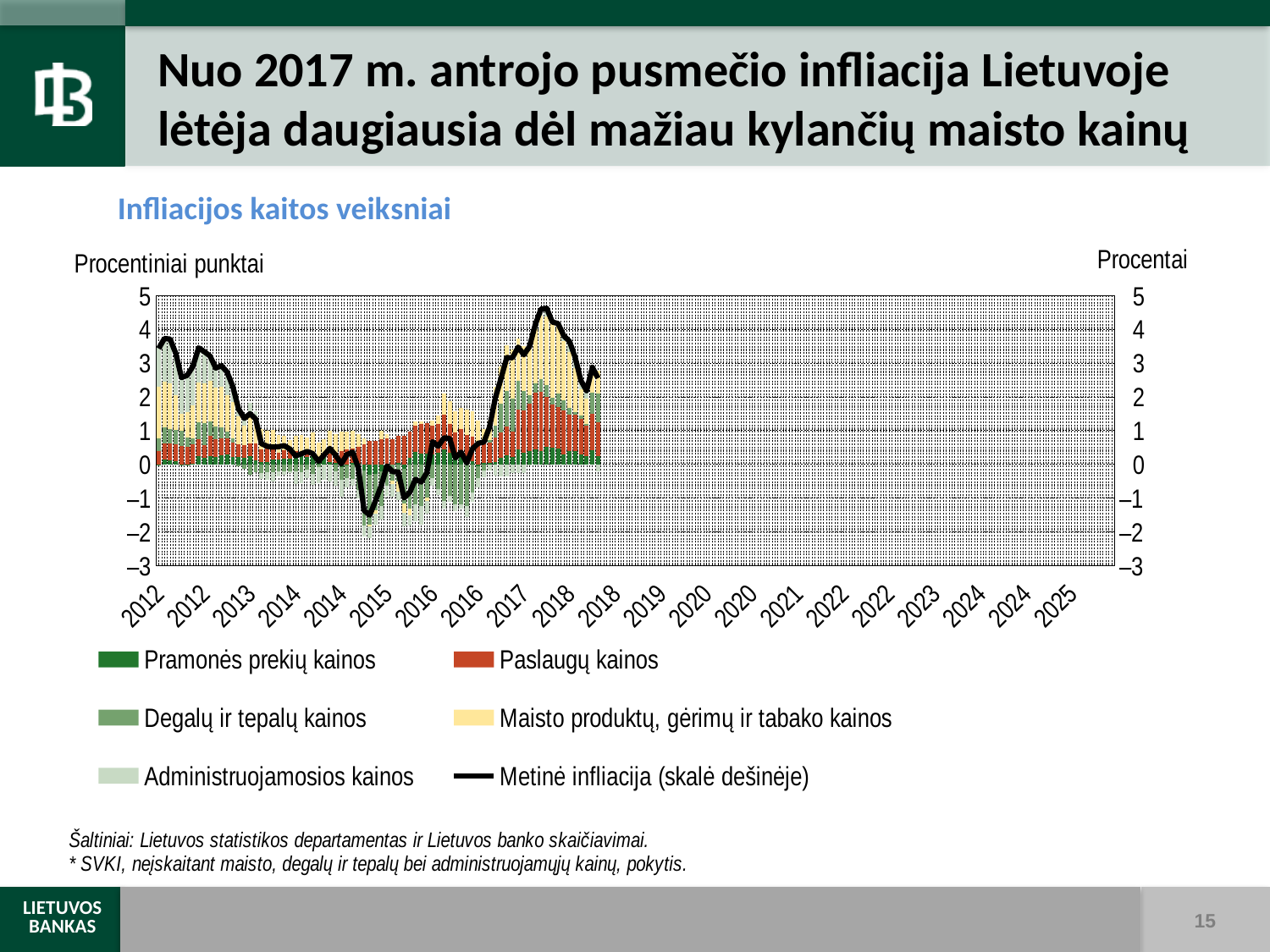
Is the last plotted value of the Metinė infliacija line in 2018 greater or less than 2? greater What kind of chart is shown on the slide? Stacked bar chart with a line What is the maximum value shown on the left axis? 5 How many series does the legend list? 6 Does the Metinė infliacija line rise or fall between 2012 and 2014? fall Is the peak value of the Metinė infliacija line in early 2018 greater or less than 4? greater Which is higher on the Metinė infliacija line: the peak in 2018 or the value at the start of 2012? the peak in 2018 Which series is plotted on the right-hand scale according to the legend? Metinė infliacija Is the lowest value of the Metinė infliacija line in 2015 greater or less than -1? less Does the Metinė infliacija line rise or fall between 2016 and early 2018? rise What is the title of the chart? Infliacijos kaitos veiksniai